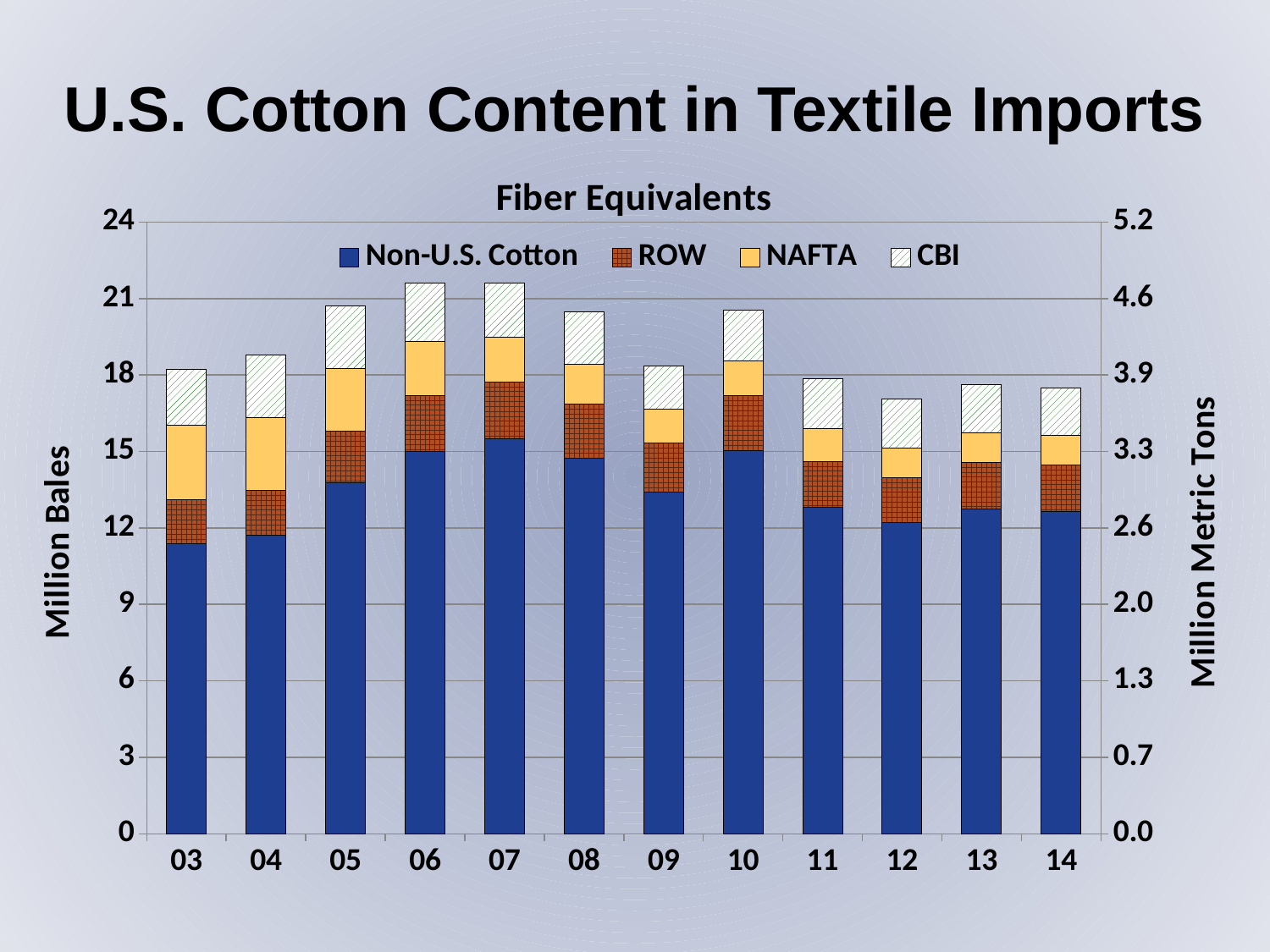
Do the total stacked values rise or fall from 03 to 06? rise Which year has the larger Non-U.S. Cotton value, 07 or 12? 07 Do the total stacked values rise or fall from 10 to 12? fall How many years are shown along the x axis of the chart? 12 Is the total stacked value for 06 greater or less than 21 million bales? greater Is the total stacked value for 12 greater or less than 18 million bales? less What is the label of the left vertical axis? Million Bales What kind of chart is shown on the slide? Stacked bar chart Which series are listed in the chart's legend? Non-U.S. Cotton, ROW, NAFTA, CBI How many series does the chart's legend list? 4 Which year has the larger total stacked bar, 05 or 11? 05 Is the Non-U.S. Cotton value for 03 greater or less than 12 million bales? less